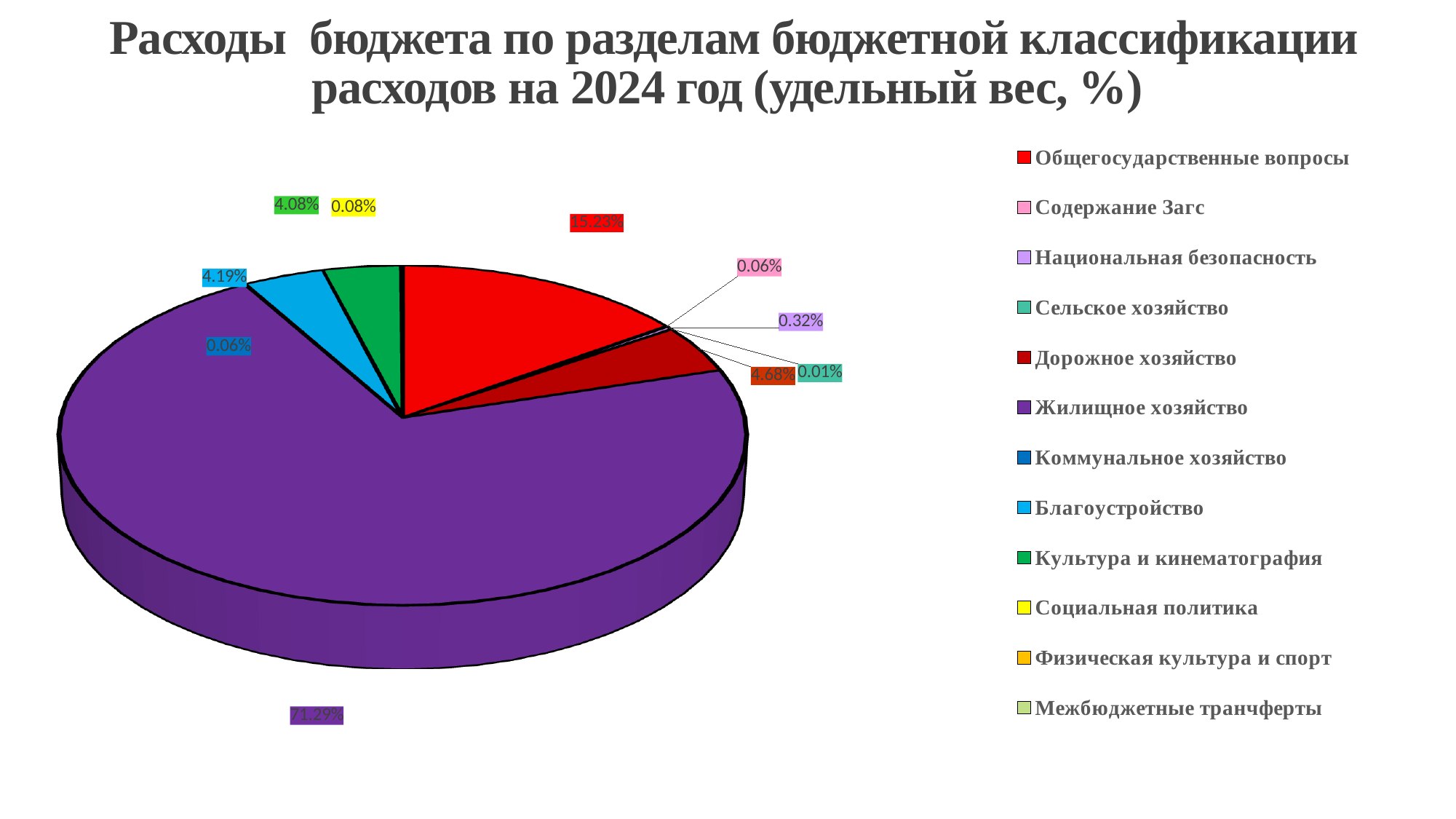
What share is shown for Культура и кинематография? 4.08% What share is shown for Благоустройство? 4.19% What share of the budget expenses is Жилищное хозяйство? 71.29% What share is shown for Социальная политика? 0.08% How many categories does the legend of the pie chart list? 12 Which category has the largest share of the pie? Жилищное хозяйство What share of the budget expenses is Общегосударственные вопросы? 15.23% By how many percentage points does the share of Жилищное хозяйство exceed that of Общегосударственные вопросы? 56.06% What kind of chart is shown on the slide? pie chart What is the title of the chart? Расходы бюджета по разделам бюджетной классификации расходов на 2024 год (удельный вес, %) Which has the larger share, Благоустройство or Культура и кинематография? Благоустройство What share is shown for Национальная безопасность? 0.32%